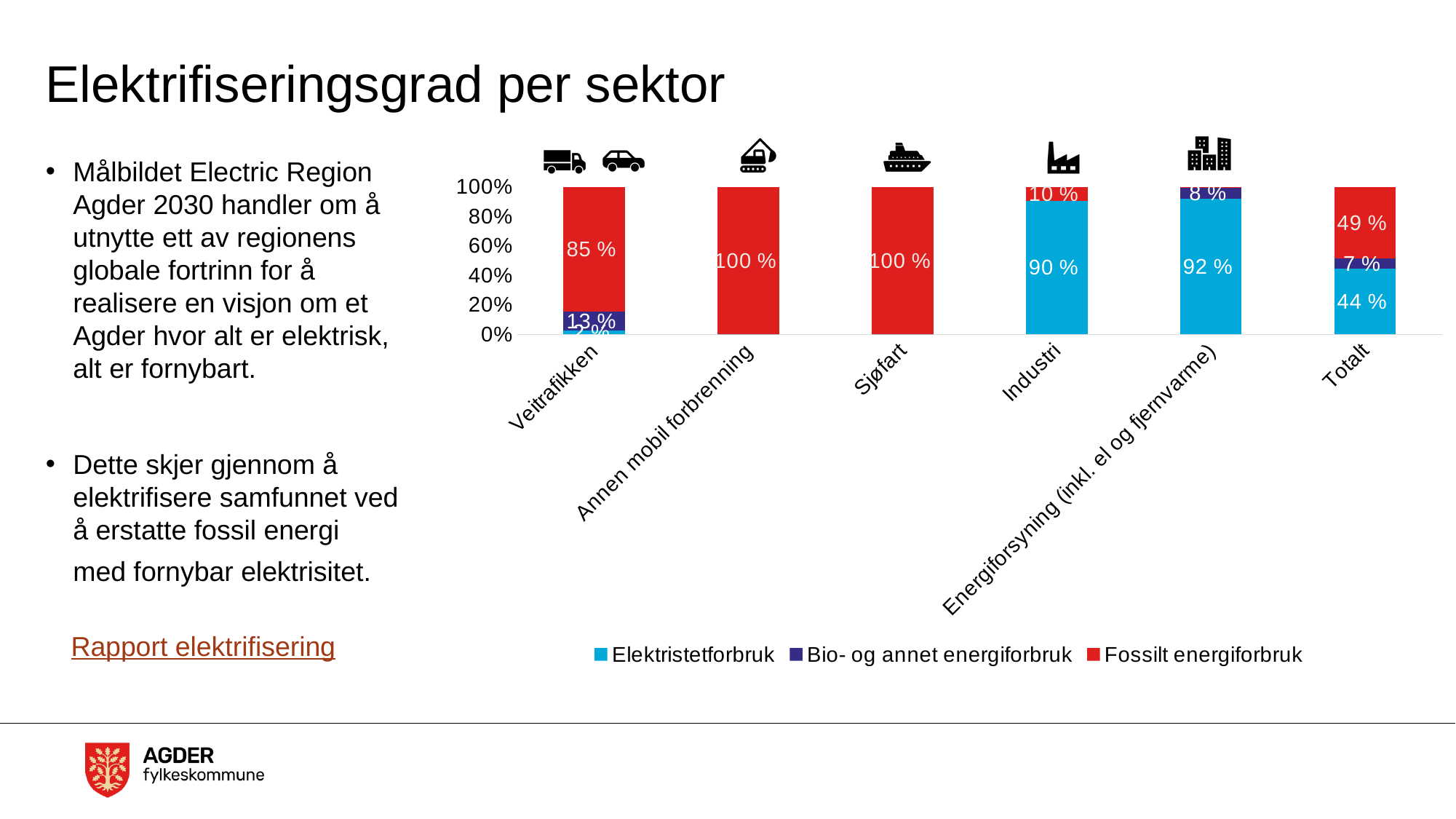
What is the share of Elektristetforbruk for Totalt? 44 % Which sector has the highest share of Elektristetforbruk? Energiforsyning (inkl. el og fjernvarme) What is the share of Fossilt energiforbruk for Totalt? 49 % Which legend entry is shown in red? Fossilt energiforbruk How many series does the chart legend list? 3 What is the share of Bio- og annet energiforbruk for Energiforsyning (inkl. el og fjernvarme)? 8 % What is the share of Elektristetforbruk for Industri? 90 % What is the difference between the Elektristetforbruk share for Energiforsyning (inkl. el og fjernvarme) and for Industri? 2 % What kind of chart is shown on the slide? Stacked bar chart Which is larger: the Fossilt energiforbruk share for Industri or for Veitrafikken? Veitrafikken How many sectors (categories) are shown on the x axis of the chart? 6 What is the share of Fossilt energiforbruk for Veitrafikken? 85 %